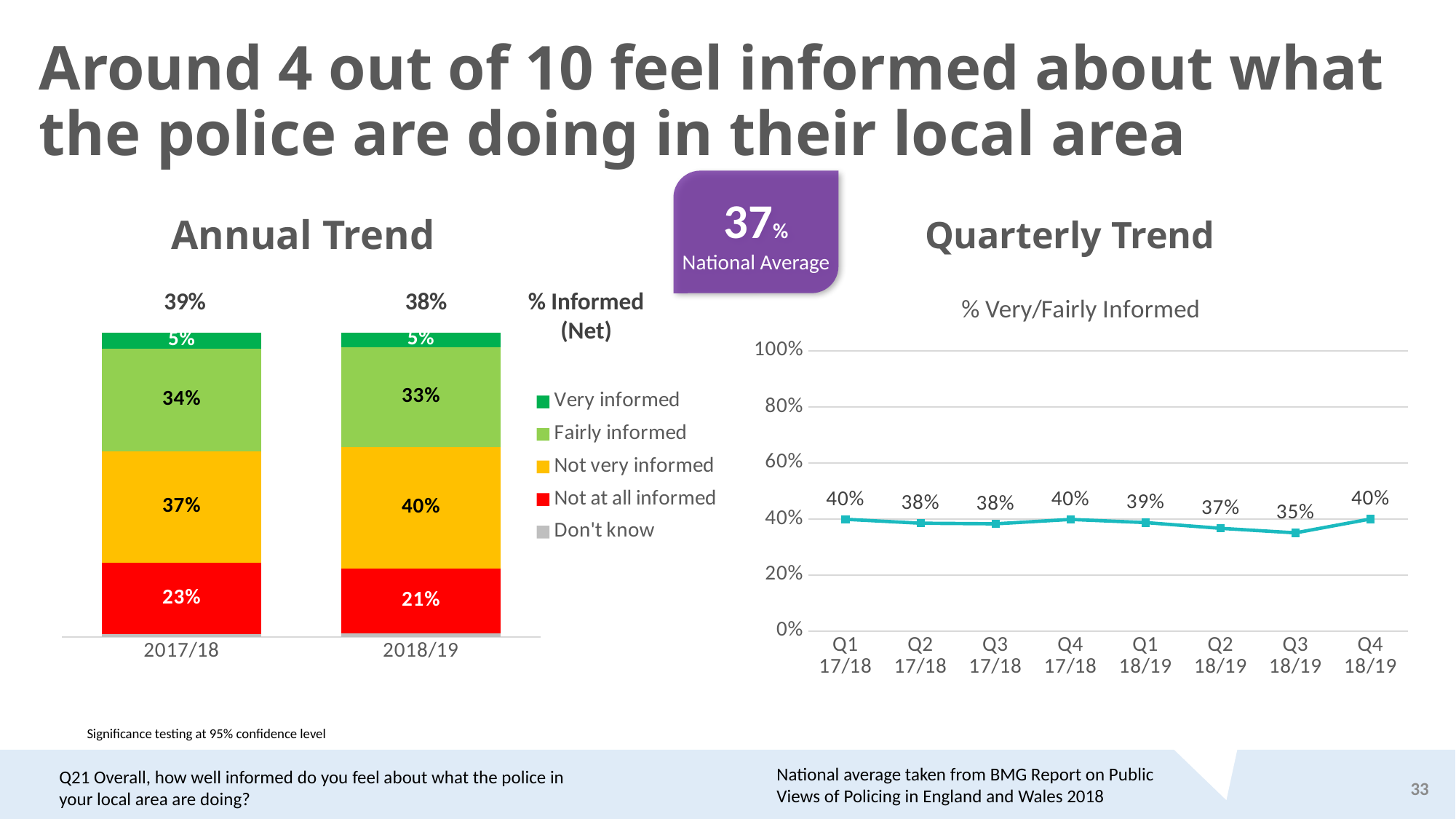
In the Annual Trend chart, what is the difference between the 'Fairly informed' percentages for 2017/18 and 2018/19? 1% What type of chart is the Annual Trend chart? Stacked bar chart What type of chart is the Quarterly Trend chart? Line chart How many quarters are plotted in the Quarterly Trend chart? 8 How many entries does the legend of the Annual Trend chart list? 5 In the Quarterly Trend chart, what is the value for Q3 18/19? 35% In the Annual Trend chart, what percentage were 'Not at all informed' in 2017/18? 23% In the Annual Trend chart, which year has the larger 'Not at all informed' percentage, 2017/18 or 2018/19? 2017/18 In the Quarterly Trend chart, what is the difference between the values for Q4 18/19 and Q3 18/19? 5% In the Annual Trend chart, what percentage were 'Not very informed' in 2018/19? 40% In the Quarterly Trend chart, which quarter has the lowest value? Q3 18/19 In the Annual Trend chart, what is the '% Informed (Net)' figure shown above the 2018/19 bar? 38%